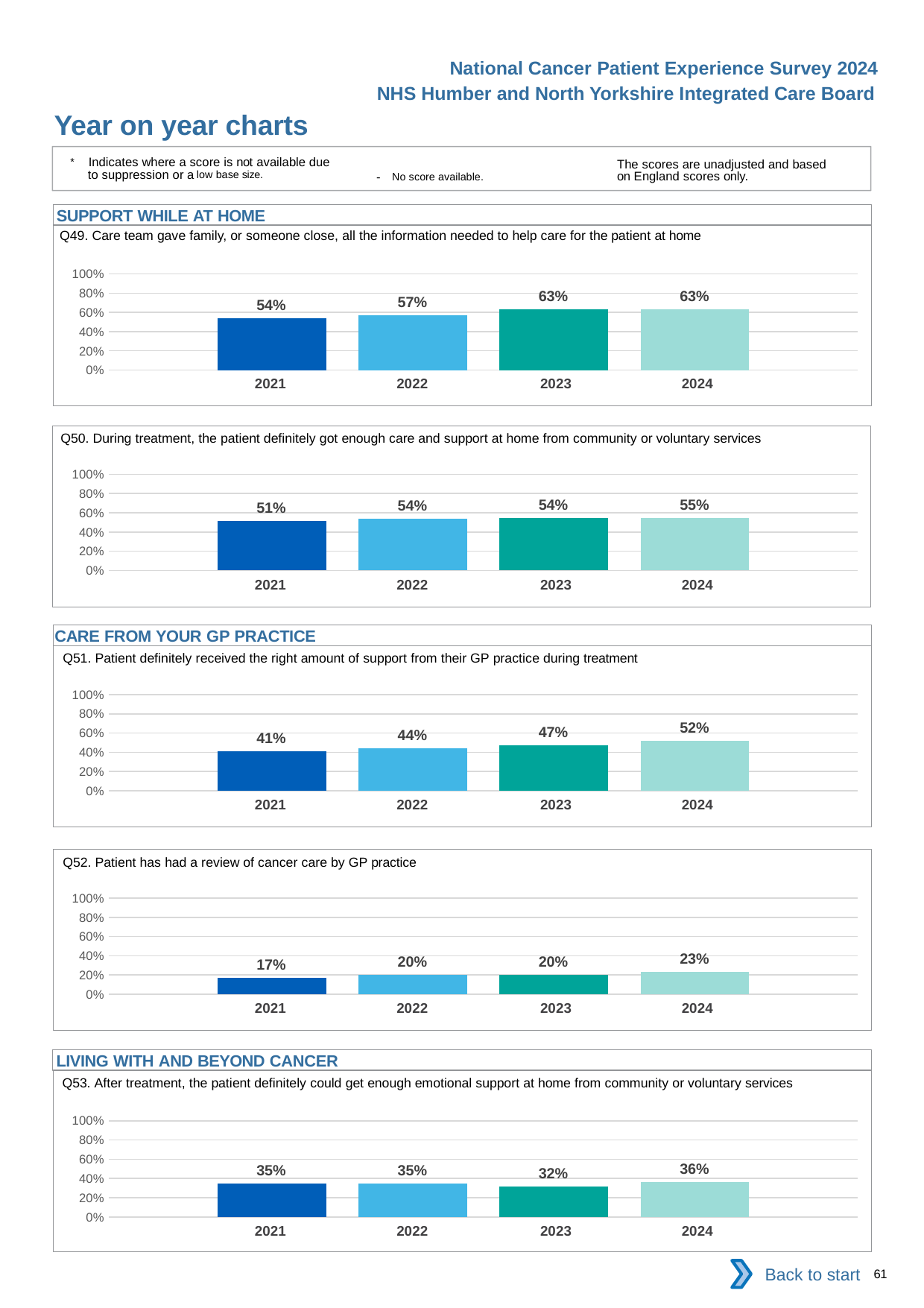
In the Q53 chart, which is larger, the value for 2024 or the value for 2023? 2024 In the Q51 chart, which year has the highest value? 2024 In the Q51 chart, do the values rise or fall from 2021 to 2024? rise In the Q52 chart, what is the value for 2021? 17% In the Q49 chart, what is the value for 2021? 54% In the Q51 chart, what is the difference between the 2024 value and the 2023 value? 5% In the Q53 chart, which year has the lowest value? 2023 In the Q50 chart, which year has the lowest value? 2021 In the Q50 chart, what is the value for 2024? 55% In the Q49 chart, what is the difference between the 2024 value and the 2021 value? 9% In the Q52 chart, is the value for 2024 greater or less than 40%? less How many years are shown in the Q53 chart? 4